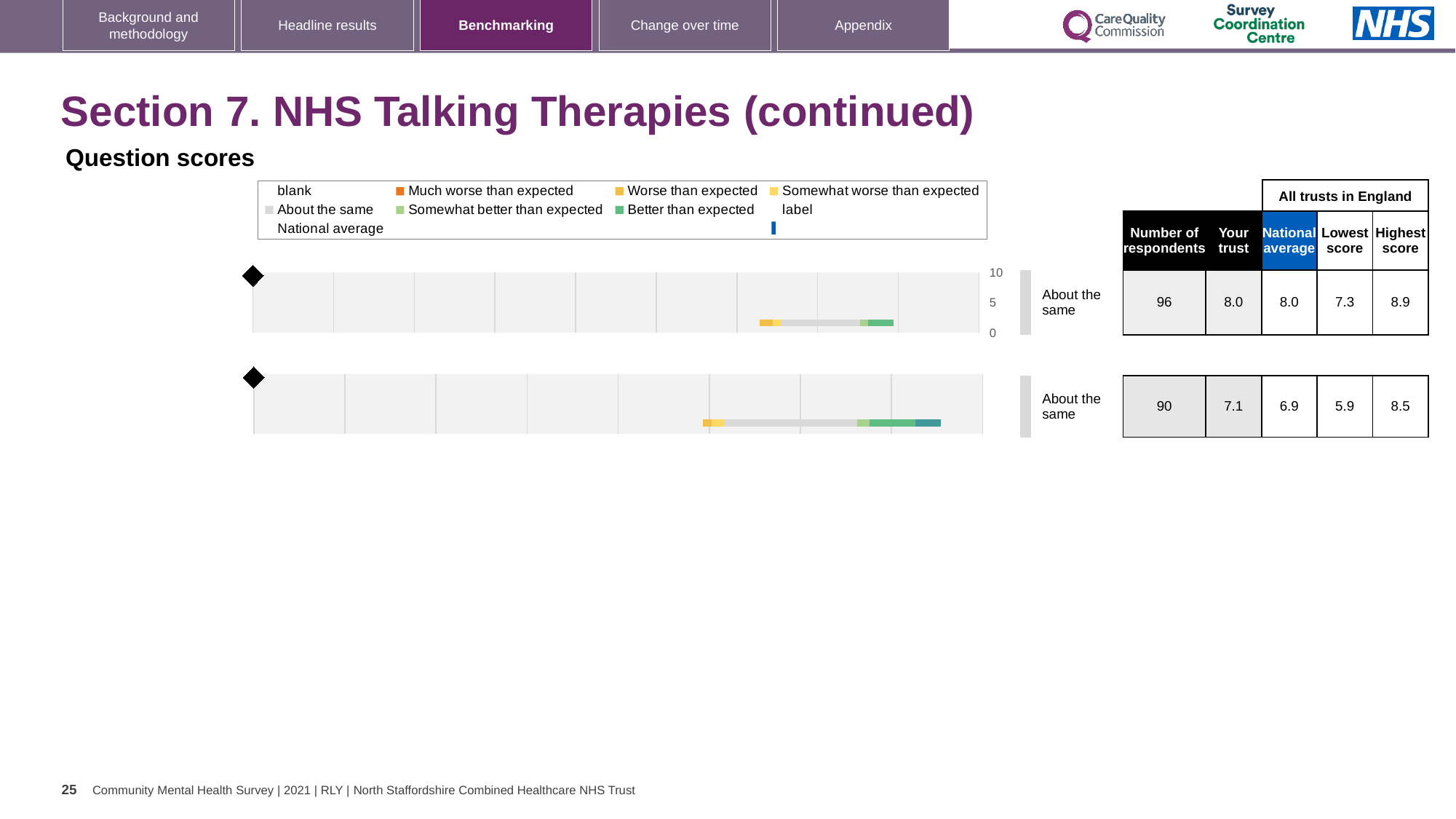
In the chart legend, which colour represents 'About the same'? grey For the bottom chart, what is the 'Your trust' score shown in the table? 7.1 How many benchmarking bar charts are shown on the slide? 2 Which chart has the larger 'Your trust' score, the top chart or the bottom chart? top chart For the bottom chart, what is the lowest score among all trusts in England? 5.9 For the top chart, what is the number of respondents shown in the table? 96 For the bottom chart, what is the national average shown in the table? 6.9 What is the highest value shown on the vertical axis of the top chart? 10 What kind of chart is used on this slide to show the question scores? bar chart For the top chart, what is the highest score among all trusts in England? 8.9 For the top chart, what is the 'Your trust' score shown in the table? 8.0 In the chart legend, which colour represents 'Much worse than expected'? orange